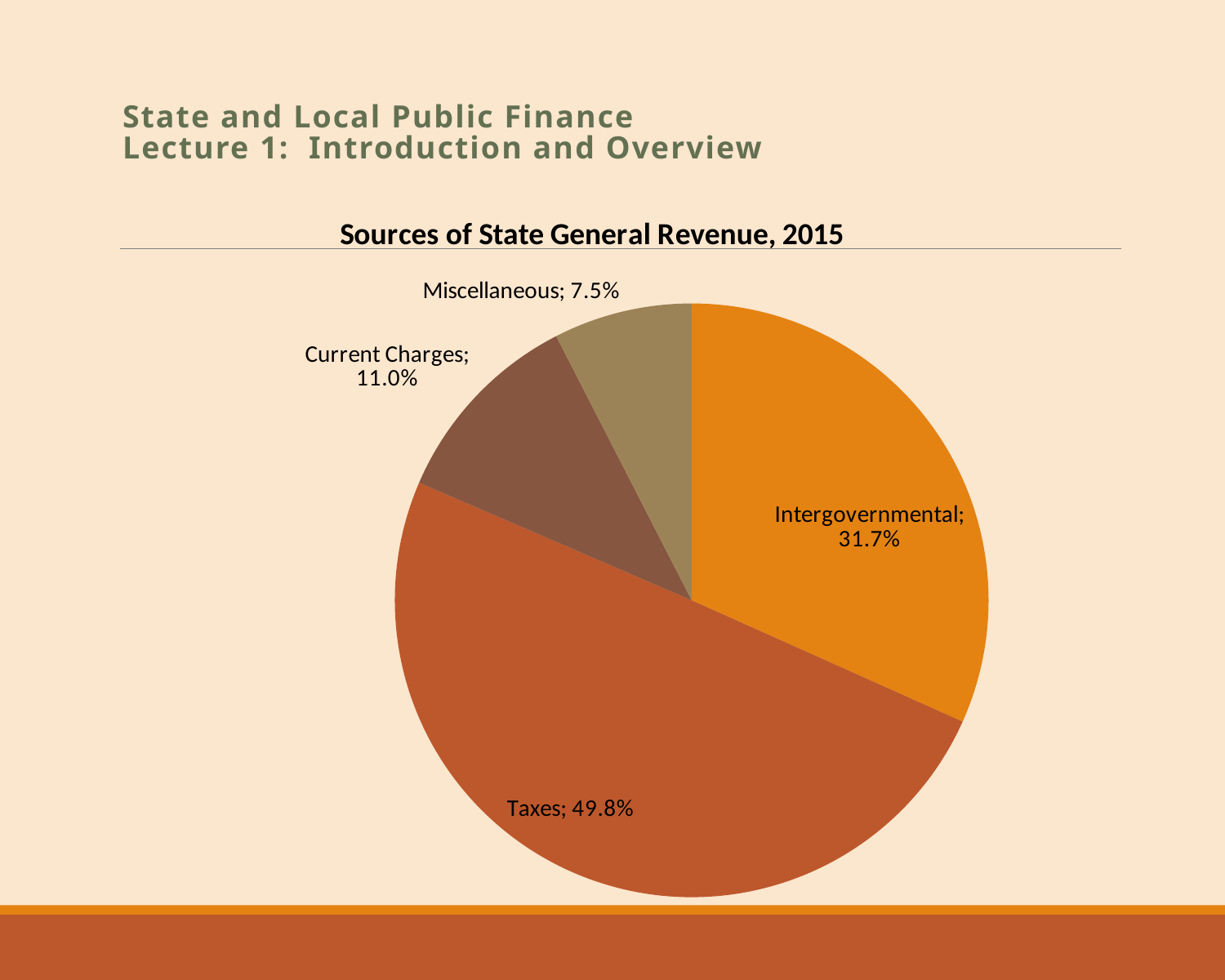
What share of state general revenue comes from Intergovernmental sources? 31.7% What type of chart is shown on the slide? Pie chart Which is larger, the share for Current Charges or the share for Miscellaneous? Current Charges What share of state general revenue comes from Taxes? 49.8% What share of state general revenue comes from Miscellaneous sources? 7.5% How many percentage points larger is the Taxes share than the Intergovernmental share? 18.1 percentage points What share of state general revenue comes from Current Charges? 11.0% Which source accounts for the smallest share of state general revenue? Miscellaneous What is the title of the chart? Sources of State General Revenue, 2015 Which source accounts for the largest share of state general revenue? Taxes What is the difference between the Current Charges share and the Miscellaneous share? 3.5 percentage points How many revenue sources are shown in the pie chart? 4